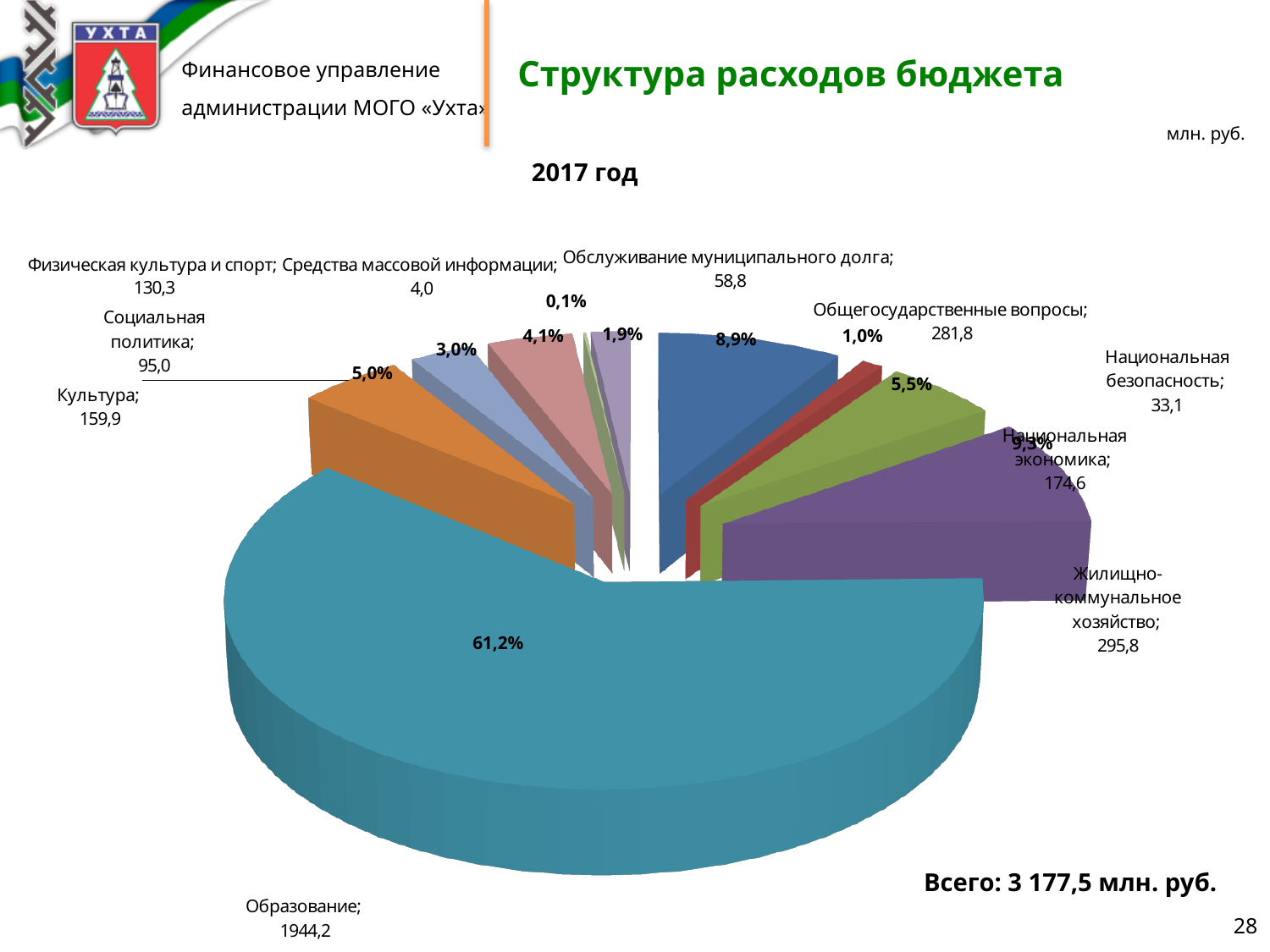
How many categories does the pie chart show? 10 What is the value for Жилищно-коммунальное хозяйство? 295,8 Which is larger, the value for Культура or the value for Социальная политика? Культура What percentage share of the pie does Жилищно-коммунальное хозяйство have? 9,3% What kind of chart is shown on the slide? pie chart What is the value for Образование? 1944,2 What is the difference between the values for Жилищно-коммунальное хозяйство and Общегосударственные вопросы? 14,0 Which category has the largest share of the pie? Образование What percentage share of the pie does Образование have? 61,2% What is the value for Средства массовой информации? 4,0 What is the value for Общегосударственные вопросы? 281,8 Which category has the smallest share of the pie? Средства массовой информации